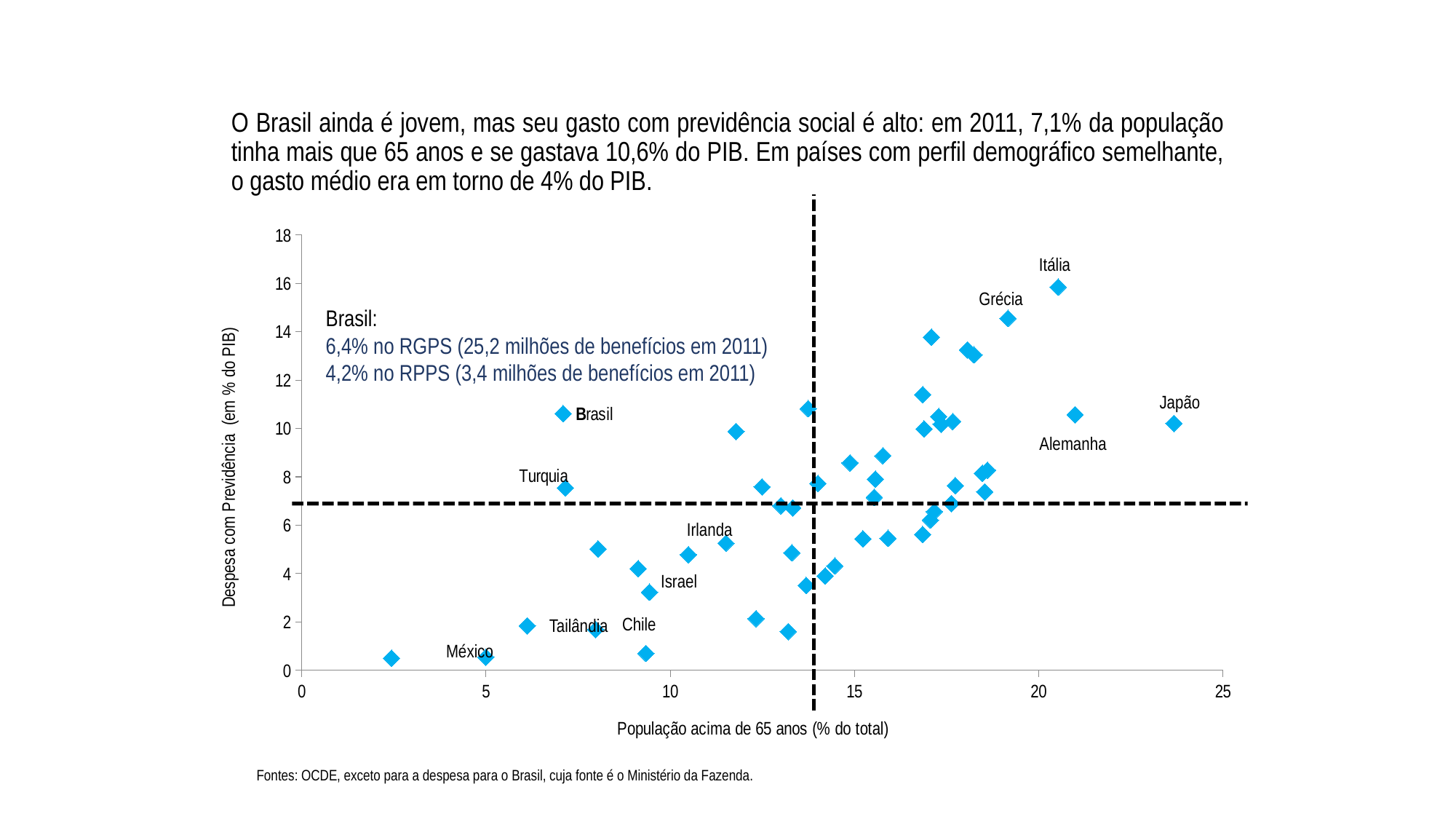
Which has higher pension spending, Itália or Grécia? Itália Which labelled country has the highest pension spending (y value)? Itália Which labelled country has the lowest pension spending (y value)? México Which has a larger share of population over 65, Japão or Alemanha? Japão Is the population-over-65 value for Japão greater or less than 20? greater What kind of chart is shown on the slide? scatter chart Is the pension spending value for Itália greater or less than 14? greater Do pension spending values generally rise or fall as the population over 65 increases along the x axis? rise Is the pension spending value for Turquia greater or less than 8? less What is the title of the y axis? Despesa com Previdência (em % do PIB) What is the title of the x axis? População acima de 65 anos (% do total)